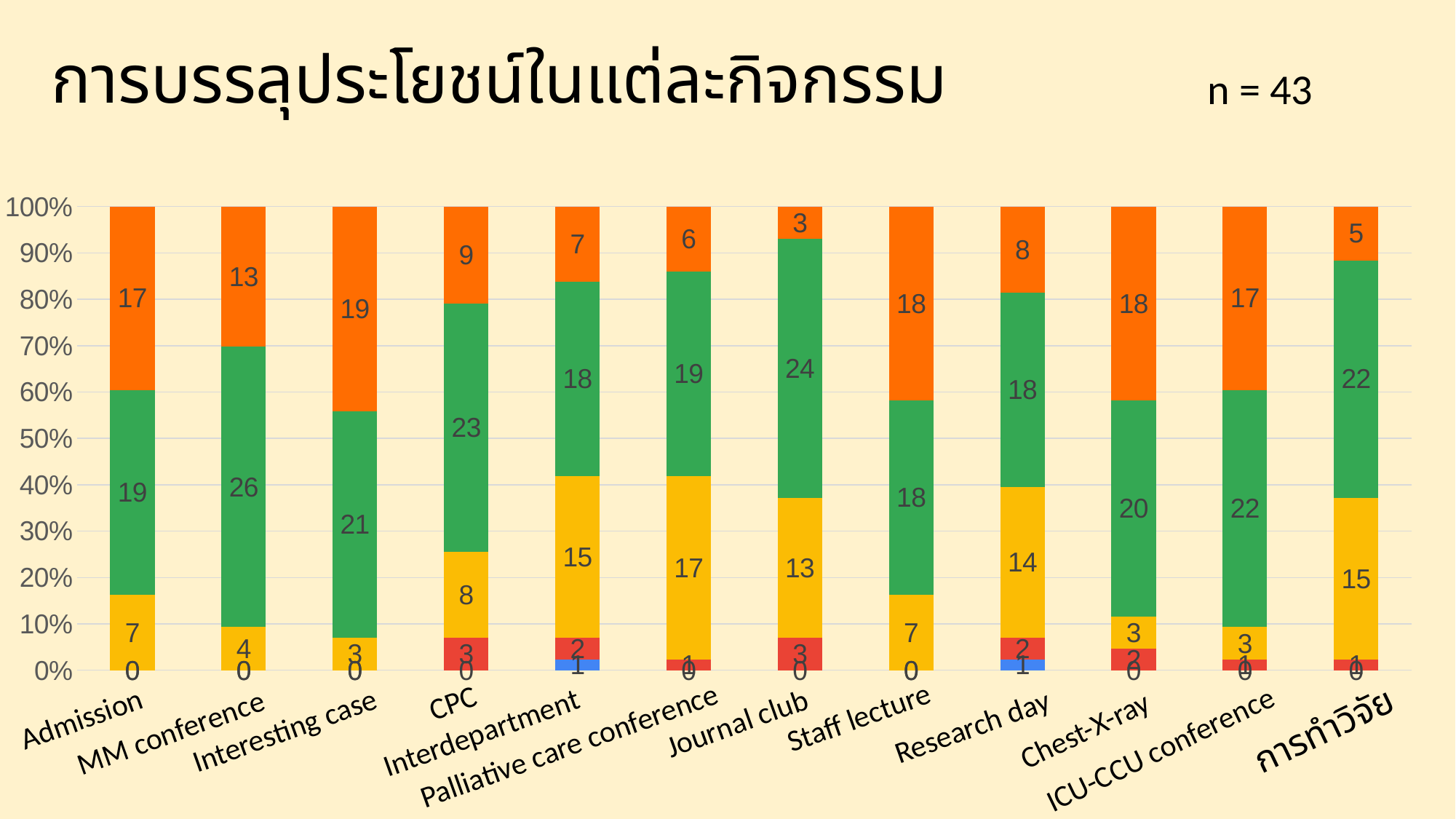
What is the difference between the green segment (19) and the orange segment (17) for Admission? 2 What is the value of the orange (top) segment for การทำวิจัย? 5 What is the value of the orange (top) segment for Interesting case? 19 What kind of chart is shown on the slide? 100% stacked bar chart What sample size (n) is stated on the slide? n = 43 How many categories are shown on the x axis? 12 What is the value of the green segment for Journal club? 24 Which category has the smallest orange (top) segment value? Journal club Which category has the largest green segment value? MM conference Which has a larger green segment value, MM conference or Admission? MM conference What is the value of the yellow segment for Palliative care conference? 17 What is the title of the chart? การบรรลุประโยชน์ในแต่ละกิจกรรม